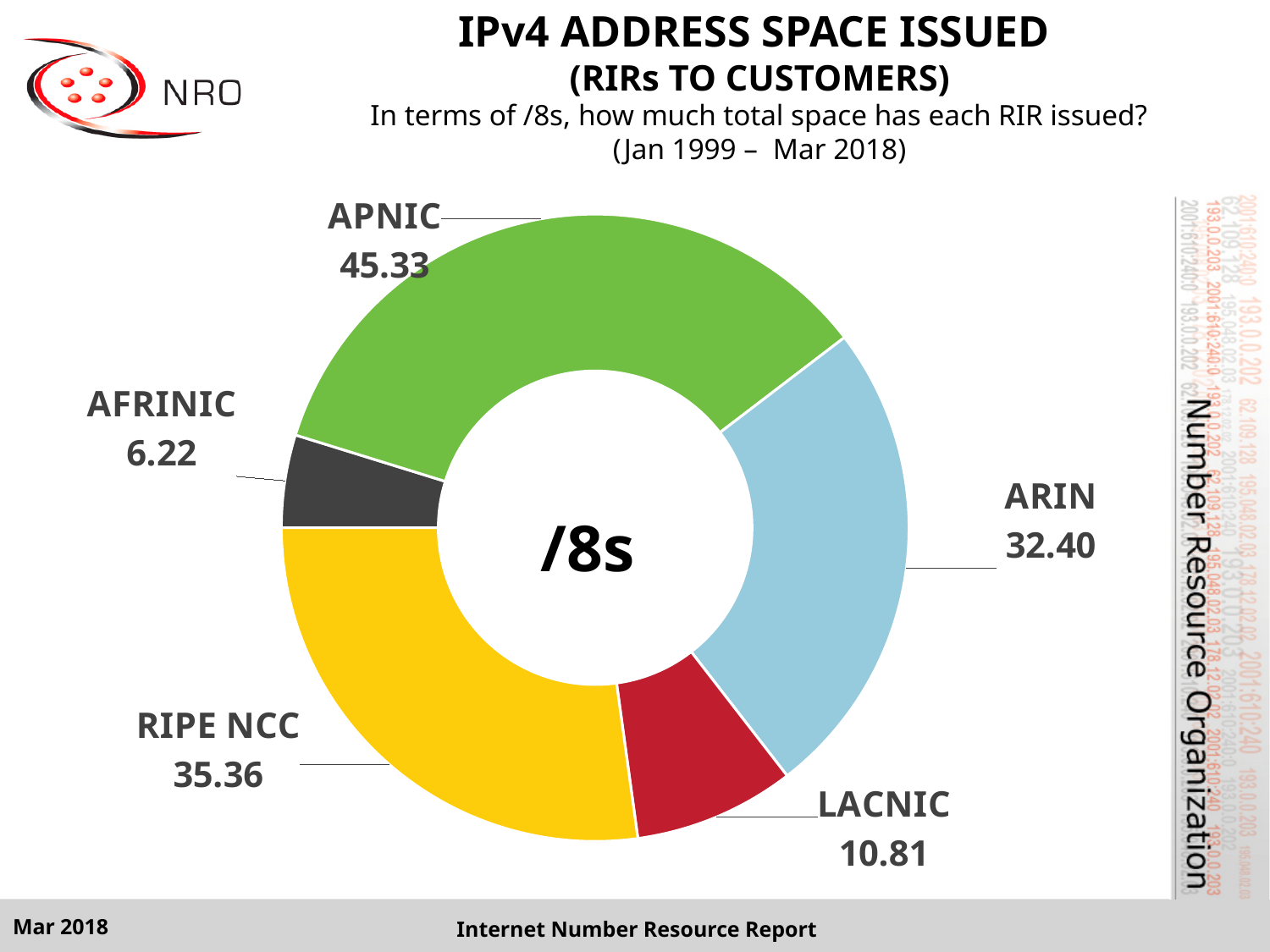
What is the difference in /8s between RIPE NCC and LACNIC? 24.55 What value is shown for LACNIC? 10.81 What is the difference in /8s between APNIC and ARIN? 12.93 What value is shown for AFRINIC? 6.22 Which RIR has issued the least IPv4 address space in /8s? AFRINIC What unit label is printed in the centre of the chart? /8s What kind of chart is used on this slide? Pie (donut) chart What value is shown for APNIC in the IPv4 address space issued chart? 45.33 Which has issued more /8s, RIPE NCC or ARIN? RIPE NCC Which RIR has issued the most IPv4 address space in /8s? APNIC How many /8s has RIPE NCC issued according to the chart? 35.36 How many RIRs are shown in the chart? 5